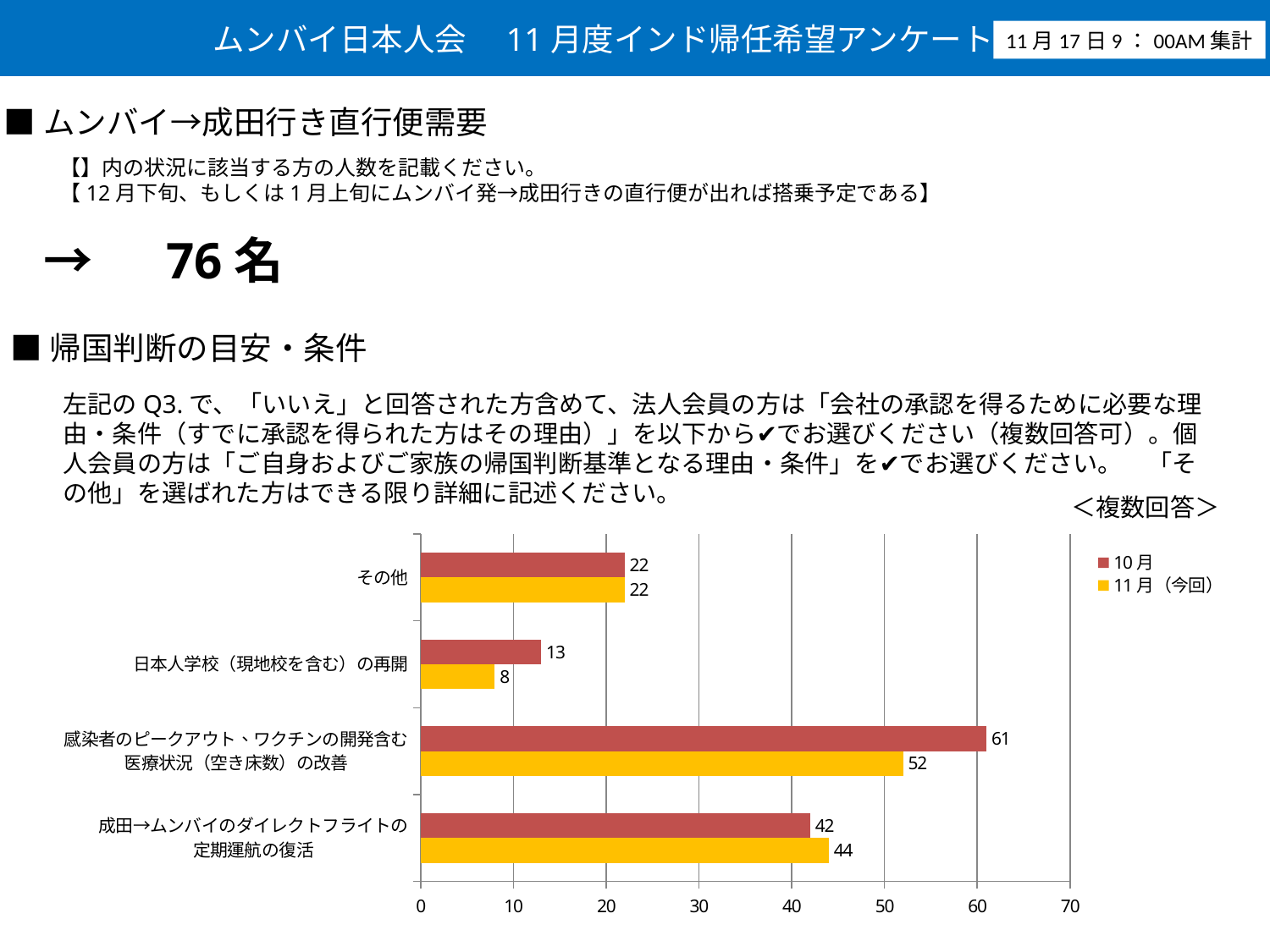
Which category has the highest 11月（今回） value? 感染者のピークアウト、ワクチンの開発含む医療状況（空き床数）の改善 How many series does the chart legend list? 2 What type of chart is shown on the slide? bar chart Which category has the lowest 10月 value? 日本人学校（現地校を含む）の再開 What is the 10月 value for その他? 22 How many categories are shown on the chart? 4 For 成田→ムンバイのダイレクトフライトの定期運航の復活, which is larger: the 10月 value or the 11月（今回） value? 11月（今回） What is the 11月（今回） value for 日本人学校（現地校を含む）の再開? 8 Which legend entry is shown in yellow? 11月（今回） What is the difference between the 10月 and 11月（今回） values for 感染者のピークアウト、ワクチンの開発含む医療状況（空き床数）の改善? 9 What is the 10月 value for 感染者のピークアウト、ワクチンの開発含む医療状況（空き床数）の改善? 61 What is the 11月（今回） value for 成田→ムンバイのダイレクトフライトの定期運航の復活? 44